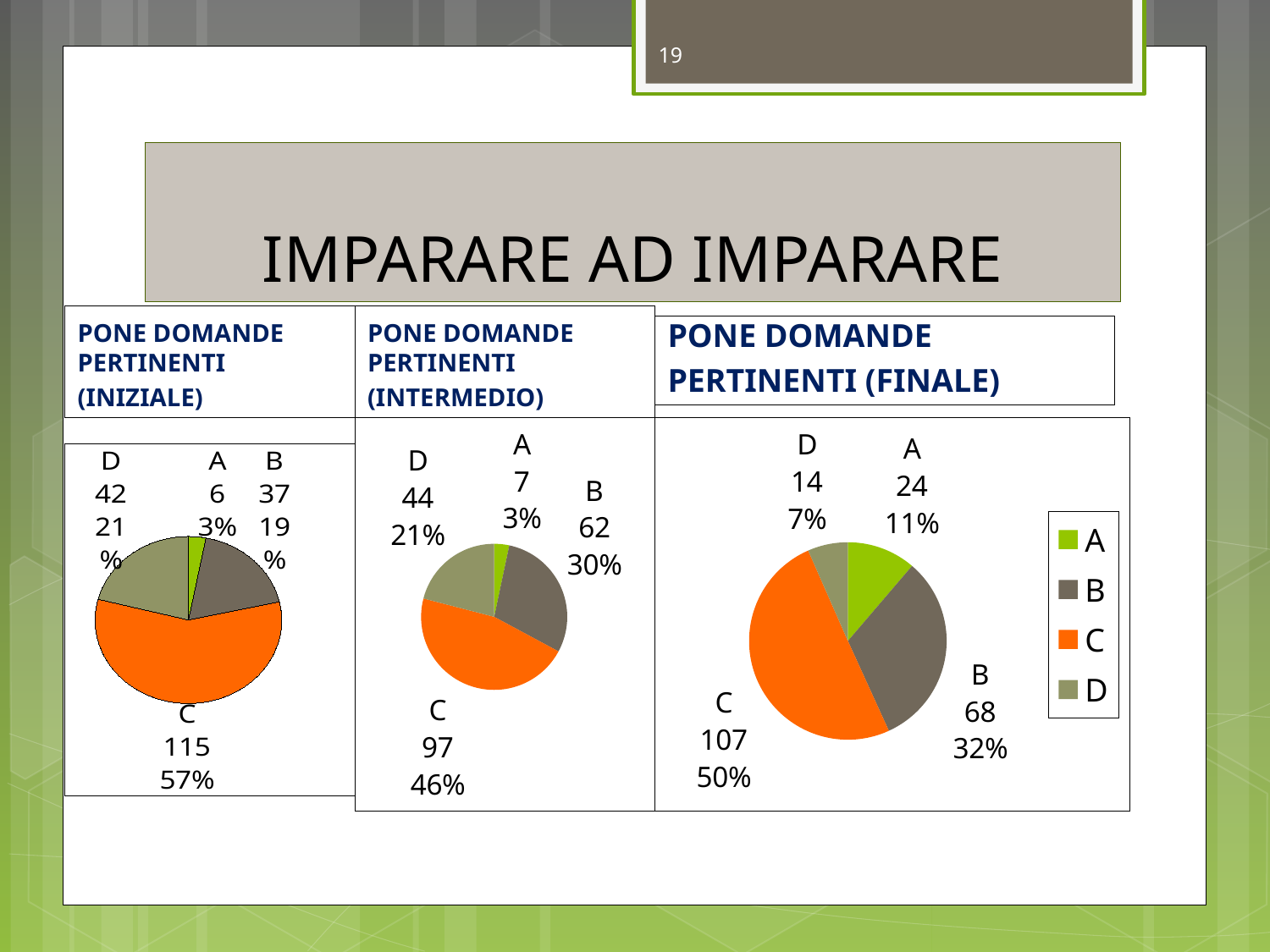
How many slices does the PONE DOMANDE PERTINENTI (FINALE) chart have? 4 In the PONE DOMANDE PERTINENTI (FINALE) chart, what percentage does slice A represent? 11% How many entries does the legend of the PONE DOMANDE PERTINENTI (FINALE) chart list? 4 In the PONE DOMANDE PERTINENTI (INTERMEDIO) chart, what is the value for D? 44 In the PONE DOMANDE PERTINENTI (FINALE) chart, what is the difference between the values for B and D? 54 In the PONE DOMANDE PERTINENTI (FINALE) chart, which category has the largest slice? C In the PONE DOMANDE PERTINENTI (INTERMEDIO) chart, which is larger, the value for B or the value for D? B In the PONE DOMANDE PERTINENTI (FINALE) chart, which colour represents category C in the legend? Orange In the PONE DOMANDE PERTINENTI (FINALE) chart, what is the value for C? 107 In the PONE DOMANDE PERTINENTI (INIZIALE) chart, what percentage does slice B represent? 19% What kind of chart is used for PONE DOMANDE PERTINENTI (INTERMEDIO)? Pie chart In the PONE DOMANDE PERTINENTI (INIZIALE) chart, which category has the smallest slice? A